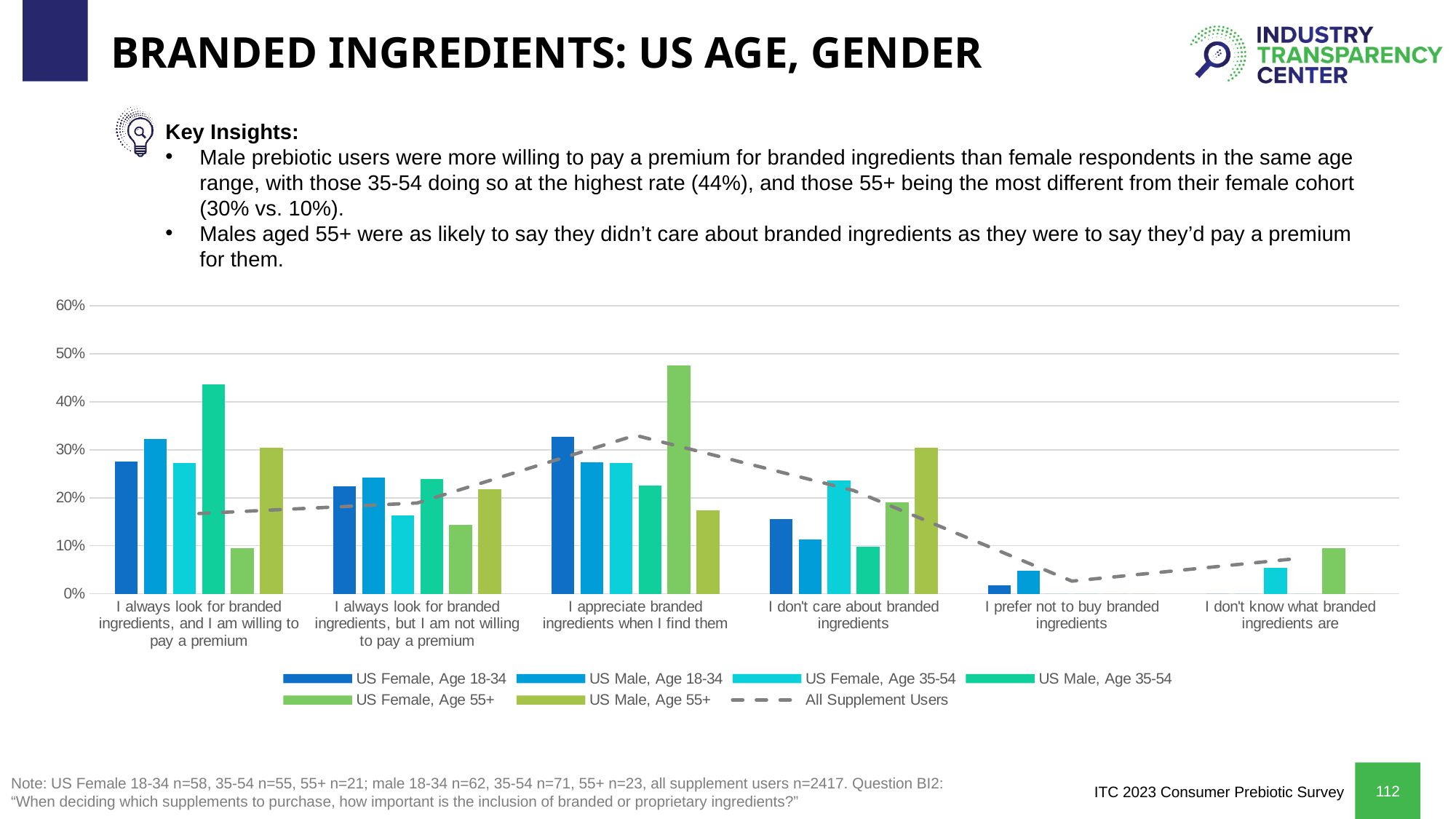
What kind of chart is shown on the slide? combination bar and line chart In the category "I always look for branded ingredients, and I am willing to pay a premium", which series has the lowest bar? US Female, Age 55+ Is the value for US Female, Age 55+ in "I appreciate branded ingredients when I find them" greater or less than 40%? greater Is the value for US Male, Age 55+ in "I don't care about branded ingredients" greater or less than 20%? greater In the category "I always look for branded ingredients, but I am not willing to pay a premium", which is larger: US Female, Age 35-54 or US Male, Age 18-34? US Male, Age 18-34 In the category "I always look for branded ingredients, and I am willing to pay a premium", which series has the highest bar? US Male, Age 35-54 In the category "I appreciate branded ingredients when I find them", which series has the highest bar? US Female, Age 55+ Is the value for US Male, Age 35-54 in "I always look for branded ingredients, and I am willing to pay a premium" greater or less than 40%? greater What does the dashed line in the chart represent? All Supplement Users How many series does the chart legend list? 7 How many categories are shown along the x axis of the chart? 6 In the category "I don't care about branded ingredients", which is larger: US Male, Age 55+ or US Female, Age 18-34? US Male, Age 55+